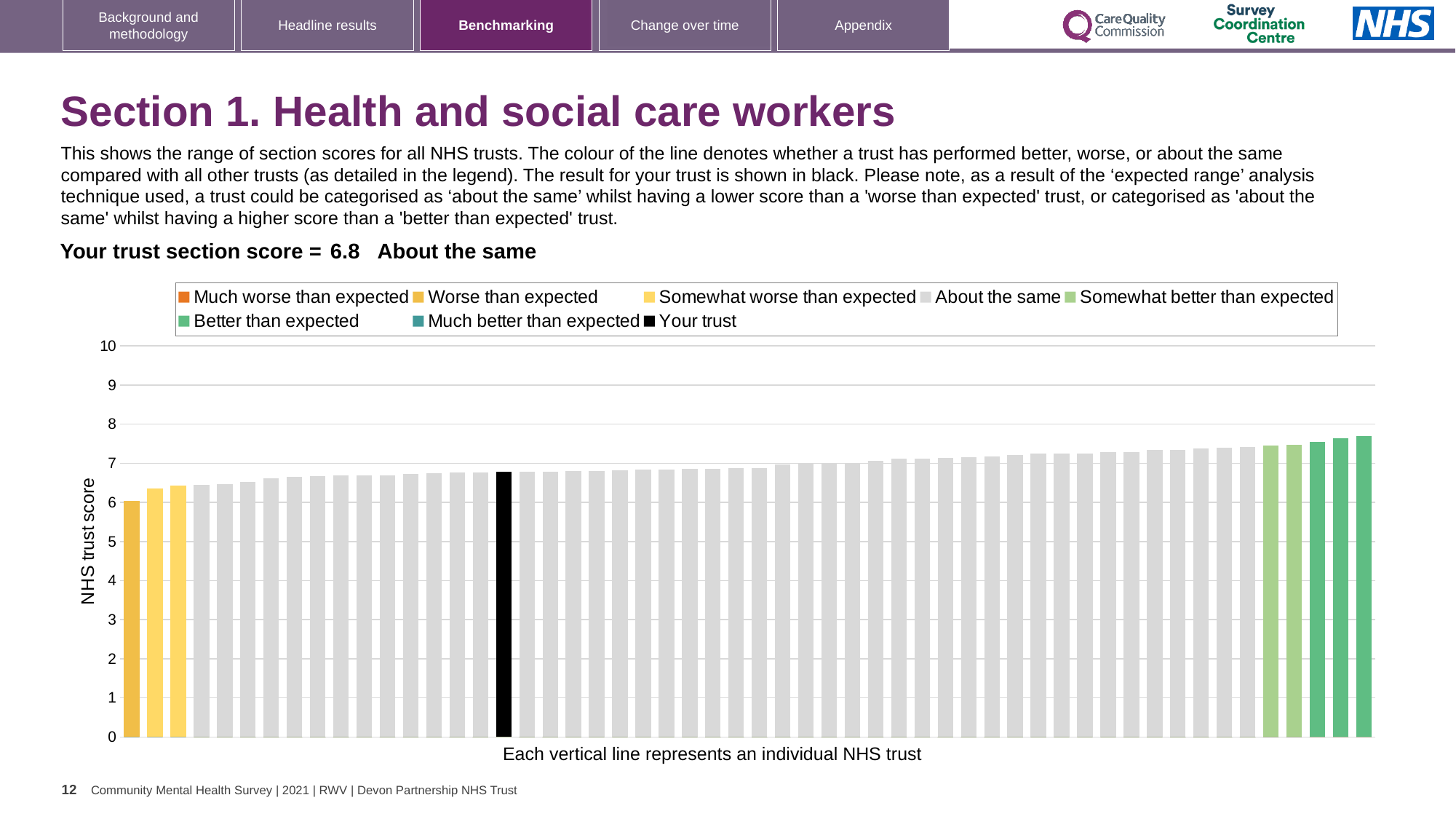
How many bars are coloured dark green (Better than expected) in the chart? 3 Which performance category is your trust placed in according to the slide? About the same Is the value of the black 'Your trust' bar greater or less than 5? greater Is the value of the shortest bar greater or less than 5? greater What is the section score for your trust shown on the slide? 6.8 Do the bar values rise or fall from left to right along the x axis? rise What is the label on the vertical axis of the chart? NHS trust score How many bars are coloured yellow (Worse than expected) in the chart? 1 What kind of chart is shown on the slide? bar chart How many entries does the chart legend list? 8 Is the value of the tallest bar greater or less than 8? less